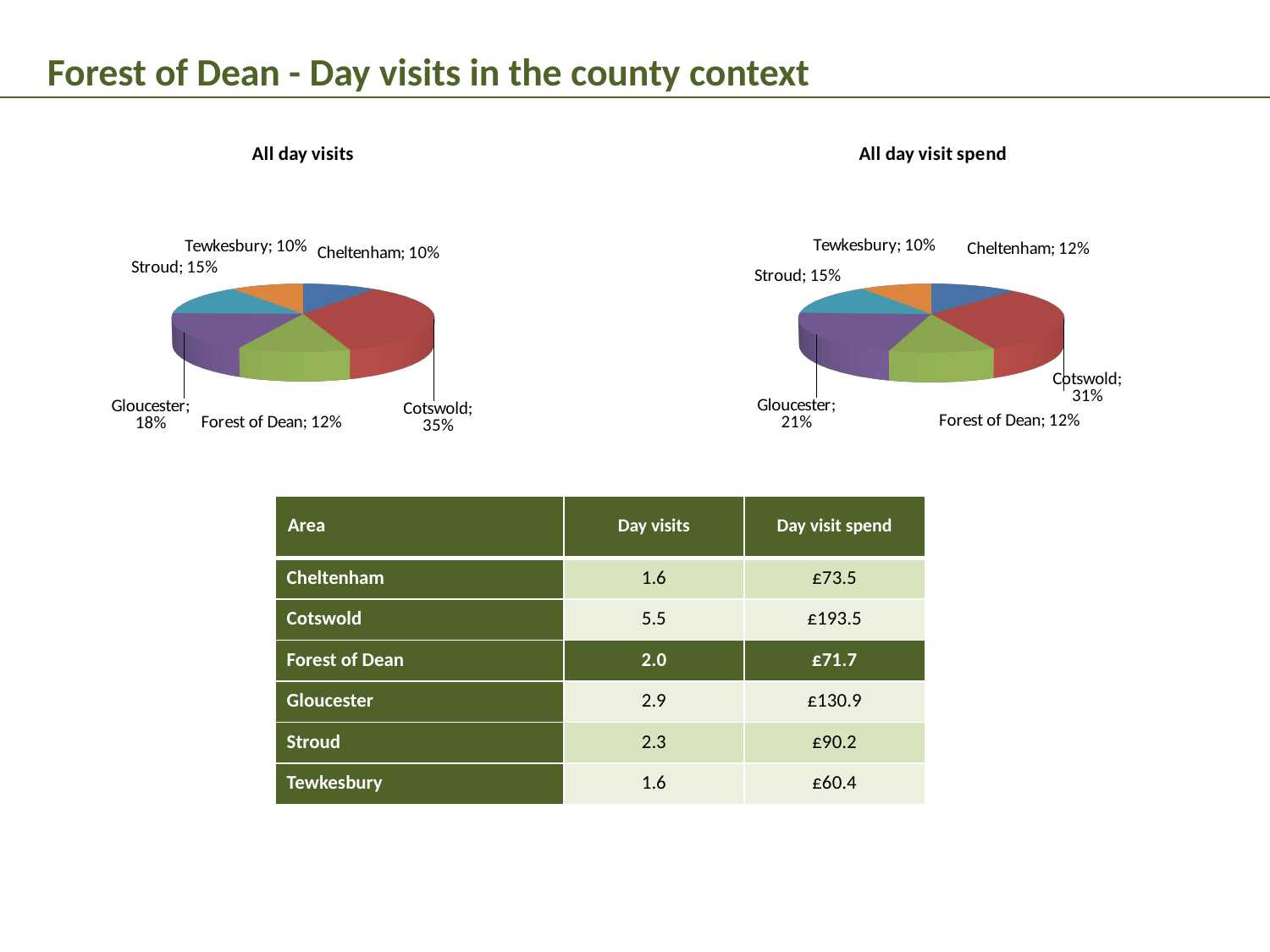
In the 'All day visit spend' chart, what share does Gloucester have? 21% What kind of chart is the 'All day visit spend' chart? Pie chart In the 'All day visits' chart, what share does Gloucester have? 18% In the 'All day visit spend' chart, what is the difference in percentage points between Cotswold and Forest of Dean? 19 In the 'All day visits' chart, what share does Cotswold have? 35% In the 'All day visits' chart, how many areas are shown? 6 In the 'All day visits' chart, which is larger, Stroud or Forest of Dean? Stroud What is the title of the chart on the left of the slide? All day visits In the 'All day visits' chart, which area has the largest slice? Cotswold In the 'All day visit spend' chart, which area has the smallest slice? Tewkesbury